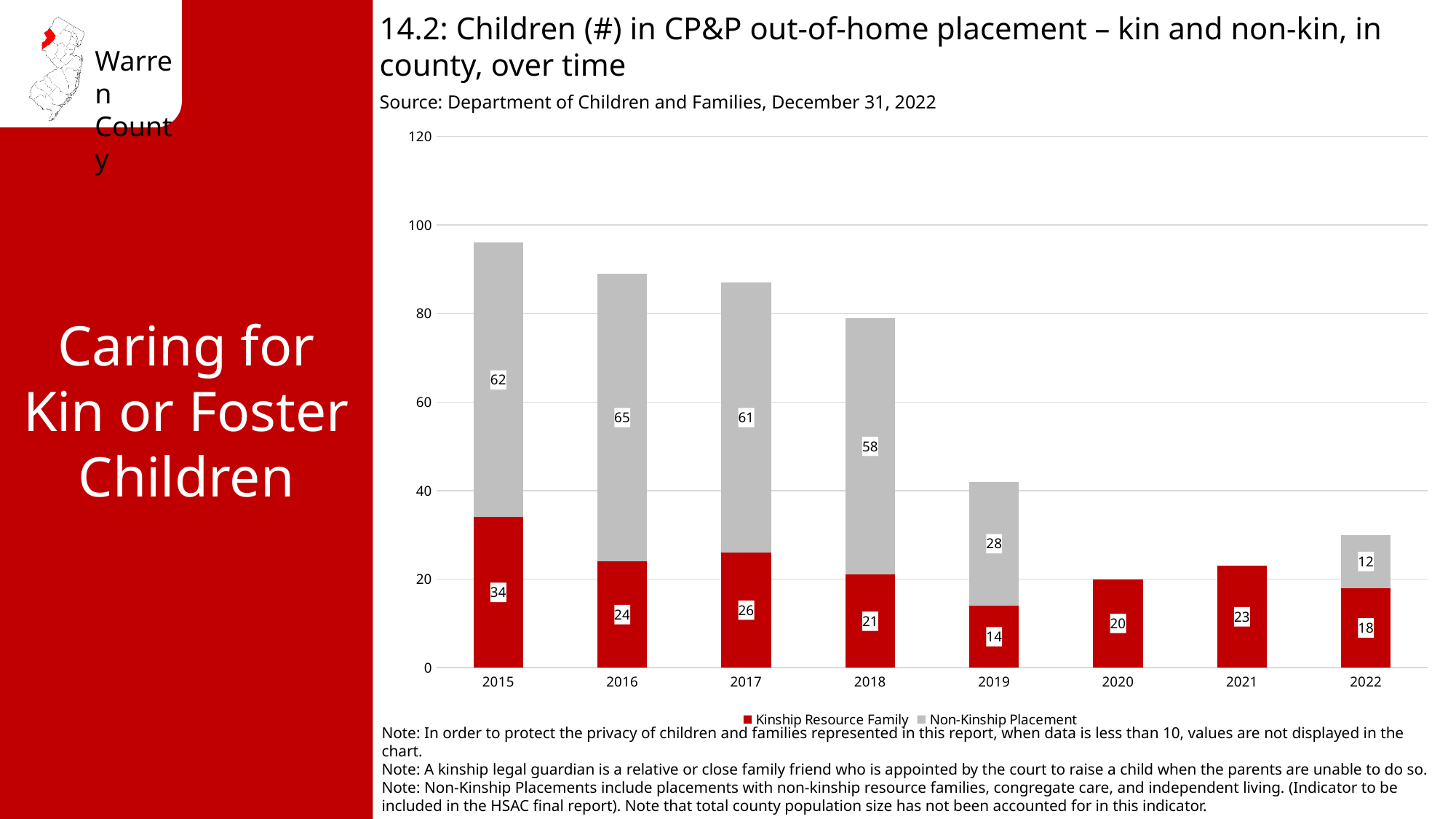
What is the Non-Kinship Placement value for 2022? 12 How many series does the legend list? 2 Which is larger, the Kinship Resource Family value for 2017 or for 2021? 2017 How many years are shown on the x axis? 8 What is the total of the stacked bar for 2015? 96 What is the difference between the Non-Kinship Placement values for 2018 and 2019? 30 Which year has the highest Kinship Resource Family value? 2015 What is the Kinship Resource Family value for 2015? 34 What is the Non-Kinship Placement value for 2016? 65 Is the total stacked bar for 2016 greater or less than 80? greater What type of chart is shown on the slide? Stacked bar chart Which year has the lowest Kinship Resource Family value? 2019